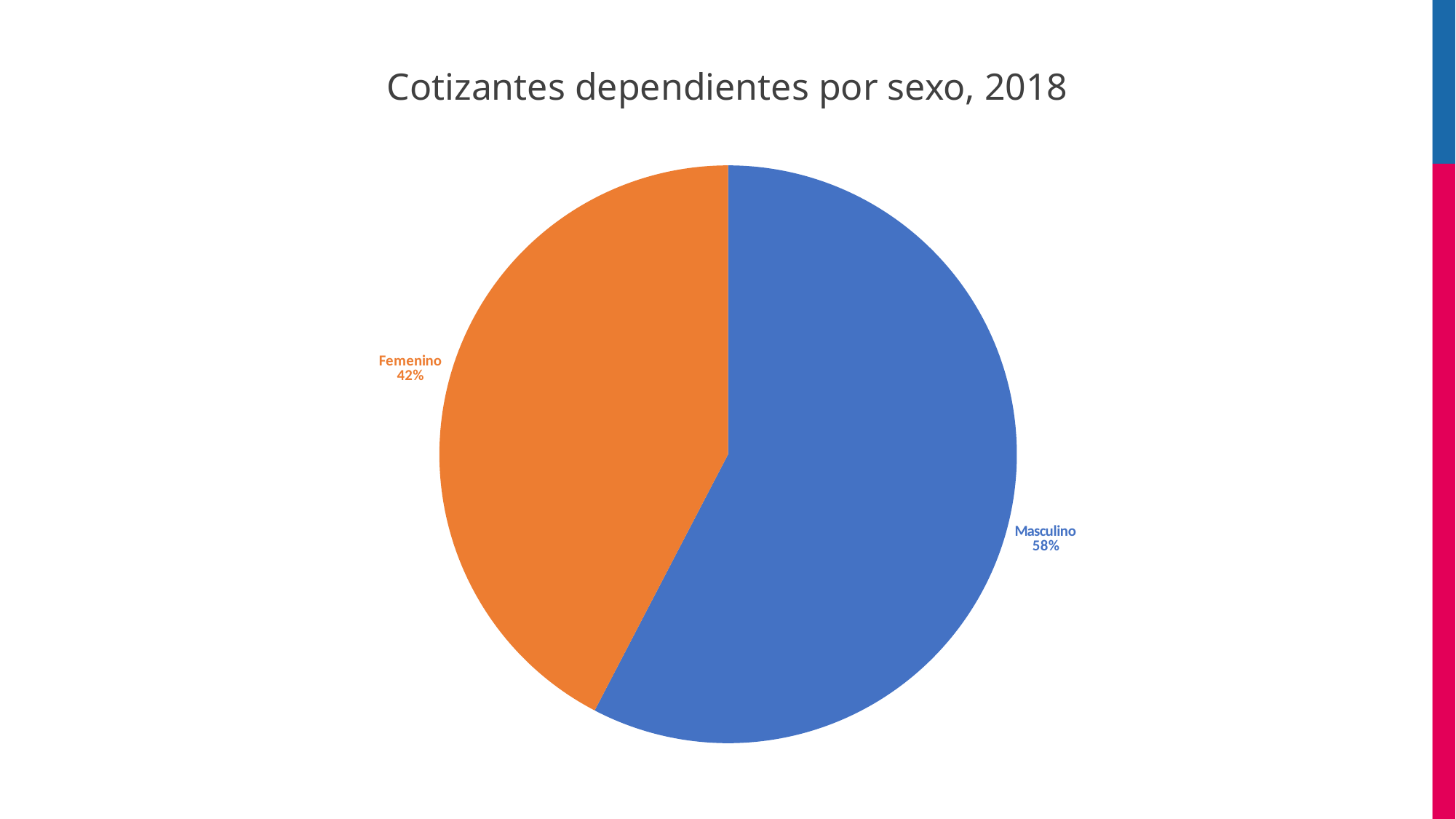
What type of chart is shown on the slide? pie chart What colour is the Femenino slice? orange Which category has the smallest slice of the pie? Femenino Which slice is larger, Femenino or Masculino? Masculino How many slices does the pie chart have? 2 What share of the pie does Femenino represent? 42% Which category has the largest slice of the pie? Masculino What share of the pie does Masculino represent? 58% Is the share for Femenino greater or less than 50%? less What is the title of the chart? Cotizantes dependientes por sexo, 2018 What is the difference in percentage points between the Masculino and Femenino slices? 16